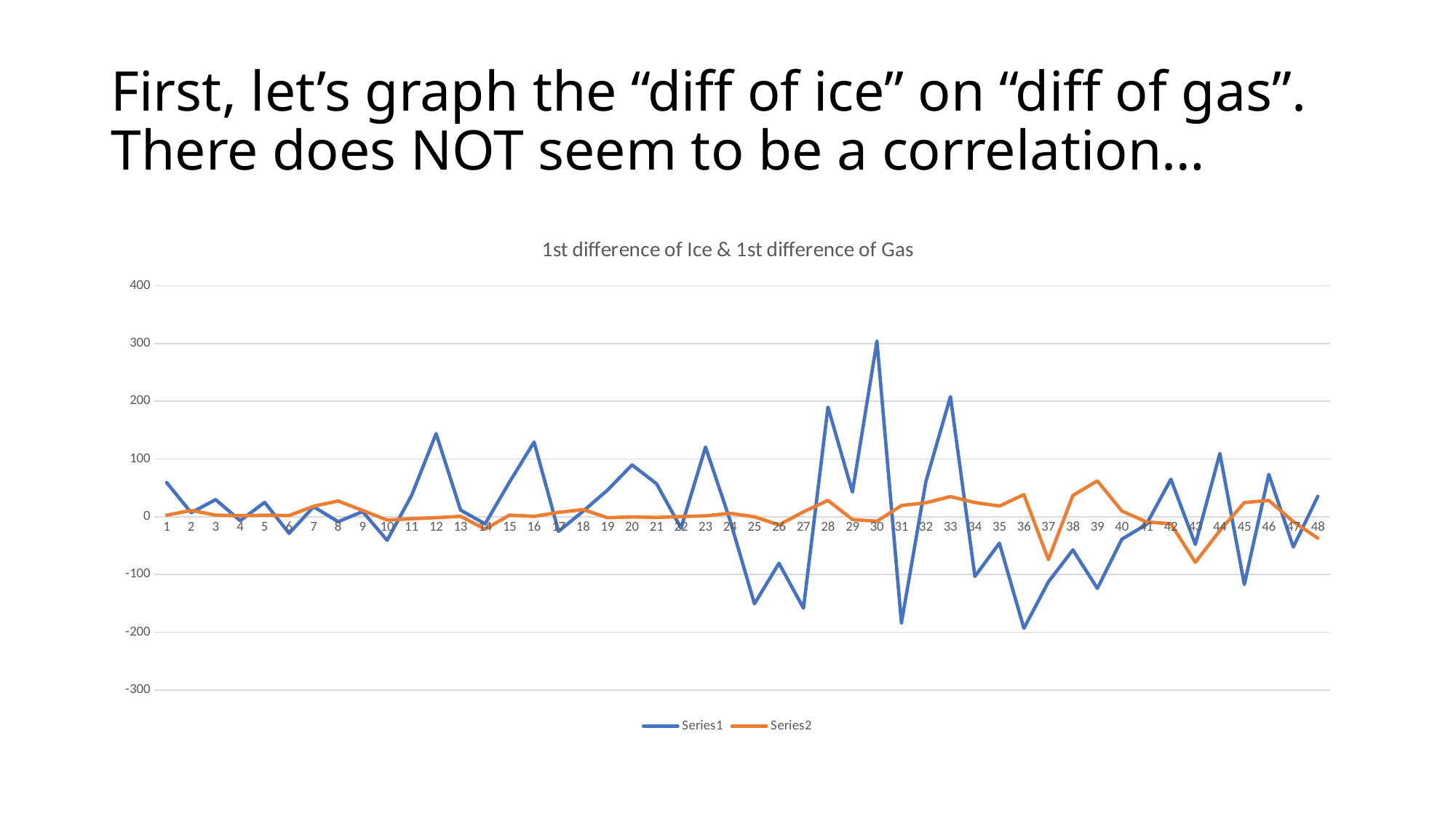
What colour is the Series2 line? orange At which x-axis point does Series1 reach its highest value? 30 Is the value of Series1 at point 30 greater or less than 200? greater Which is larger: the value of Series2 at point 39 or at point 37? point 39 Is the value of Series1 at point 36 greater or less than -100? less Which is larger: the value of Series1 at point 30 or at point 33? point 30 What is the title of the chart? 1st difference of Ice & 1st difference of Gas At which x-axis point does Series2 reach its highest value? 39 How many series does the legend list? 2 How many points are plotted along the x axis for each series? 48 What kind of chart is shown on the slide? line chart Is the value of Series1 at point 12 greater or less than 100? greater